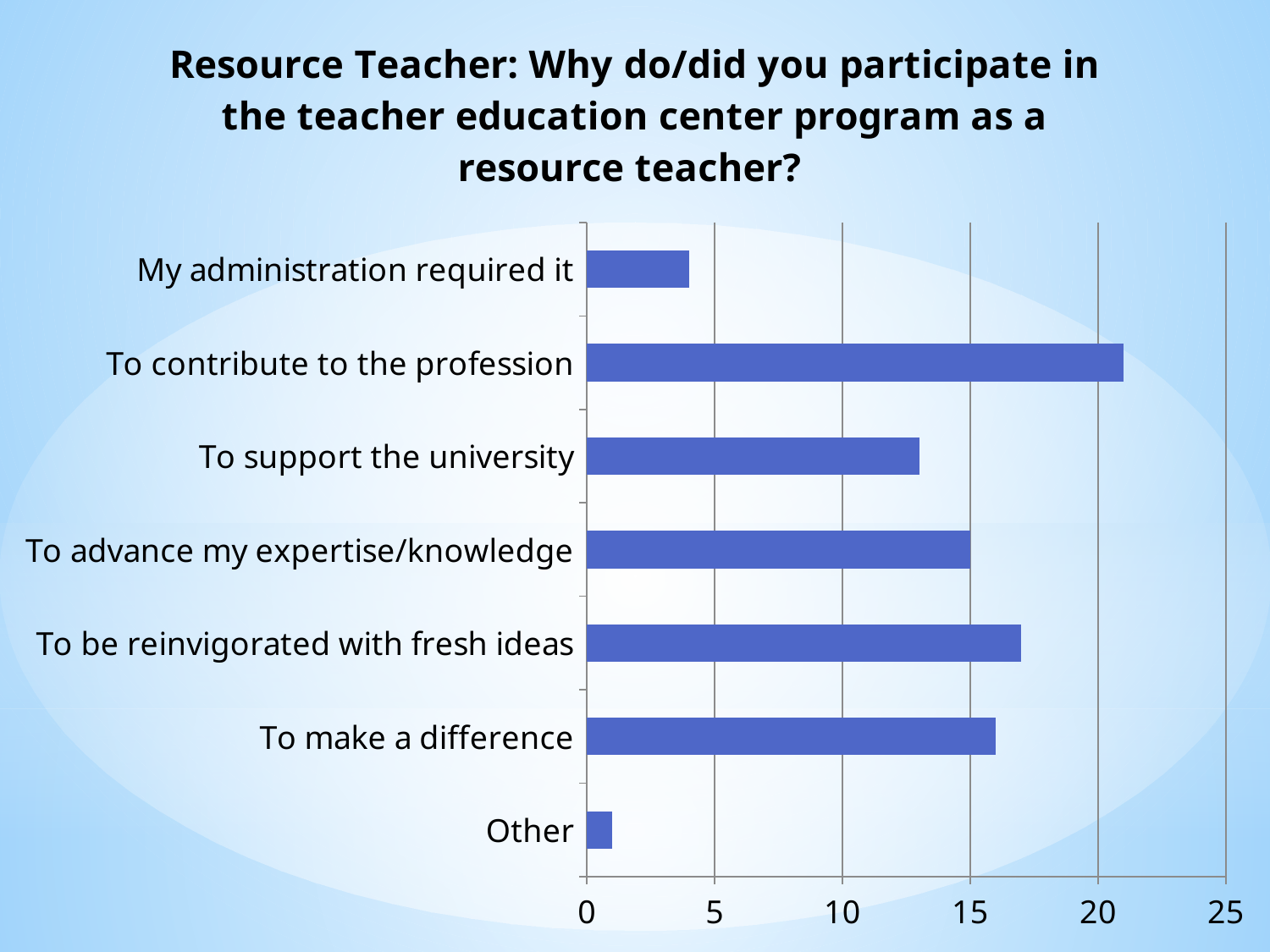
How many categories (reasons) are shown on the chart? 7 Is the value for "To be reinvigorated with fresh ideas" greater or less than 15? greater Which reason has the lowest value? Other Is the value for "Other" greater or less than 5? less Which is larger: the value for "My administration required it" or the value for "To make a difference"? To make a difference Which is larger: the value for "To contribute to the profession" or the value for "To support the university"? To contribute to the profession What kind of chart is shown on the slide? Bar chart What is the highest value shown on the horizontal axis of the chart? 25 Is the value for "To support the university" greater or less than 10? greater Which reason has the highest value? To contribute to the profession